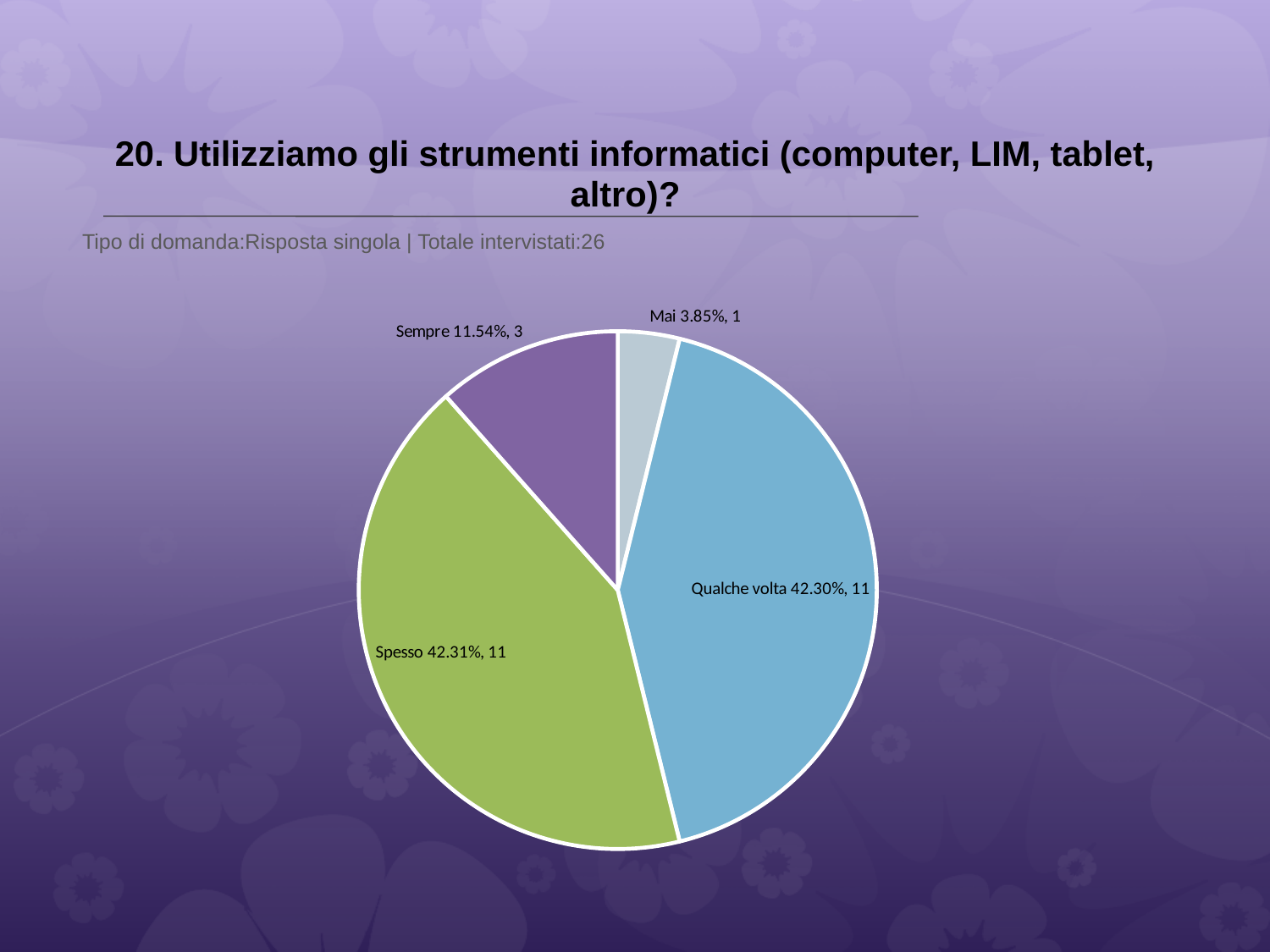
What percentage share does the 'Qualche volta' slice have? 42.30% What percentage share does the 'Sempre' slice have? 11.54% How many slices does the pie chart have? 4 What kind of chart is shown on the slide? pie chart Which category has the smallest slice of the pie? Mai How many more respondents answered 'Spesso' than 'Sempre'? 8 How many respondents answered 'Sempre'? 3 How many more respondents answered 'Sempre' than 'Mai'? 2 What percentage share does the 'Spesso' slice have? 42.31% What is the total number of respondents (Totale intervistati) stated on the slide? 26 Which slice is larger, 'Sempre' or 'Mai'? Sempre How many respondents answered 'Mai'? 1